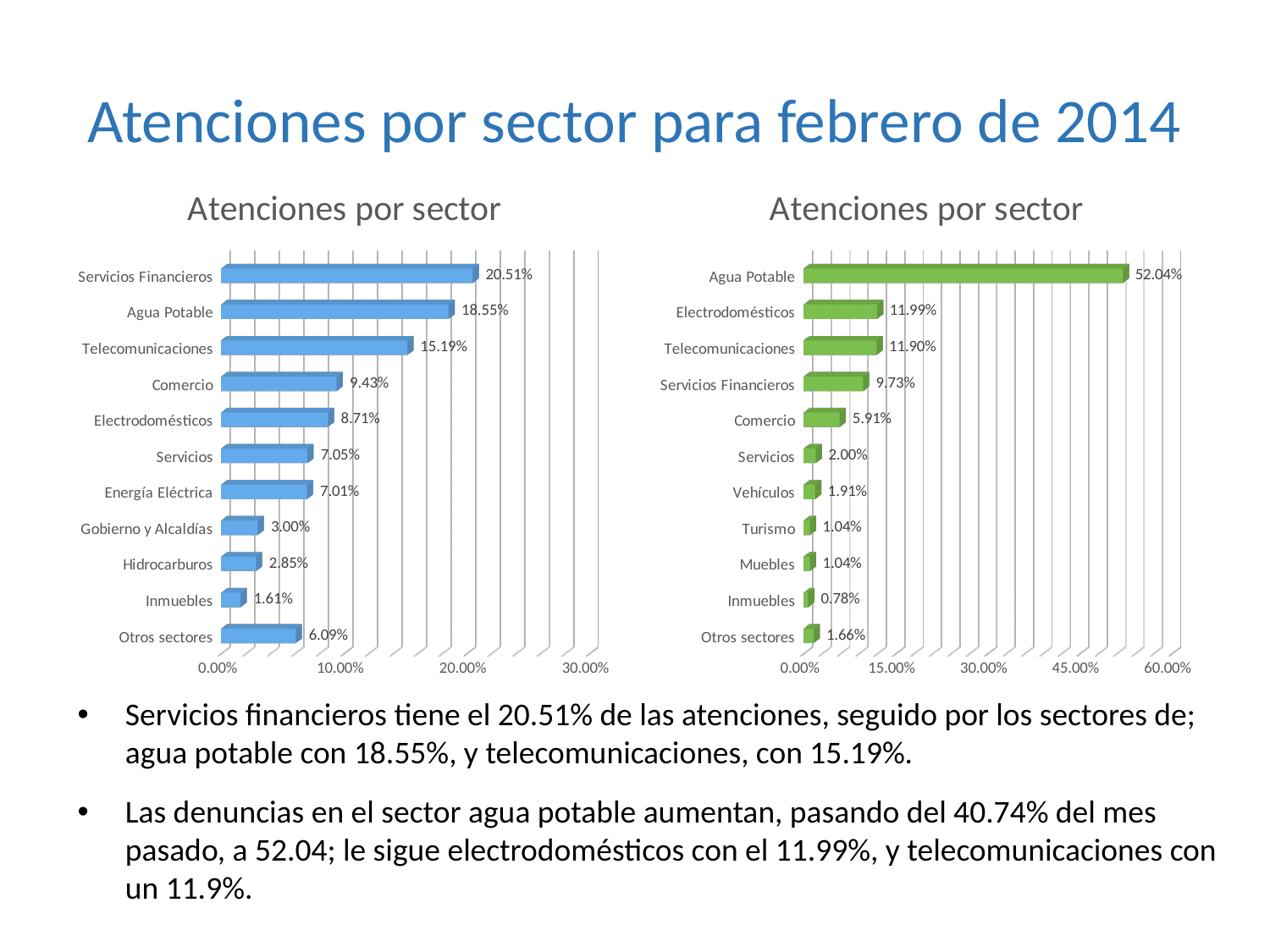
In the right chart, which is larger, Comercio or Servicios? Comercio In the left chart, is the value for Comercio greater or less than 10.00%? less In the left chart, which category has the lowest value? Inmuebles In the left chart, what is the value for Hidrocarburos? 2.85% How many categories are shown in the right chart? 11 In the left chart, what is the value for Servicios Financieros? 20.51% In the right chart, what is the value for Vehículos? 1.91% In the right chart, which category has the highest value? Agua Potable In the right chart, what is the value for Agua Potable? 52.04% In the left chart, what is the difference between Agua Potable and Telecomunicaciones? 3.36% What is the title of the right chart? Atenciones por sector What kind of chart is the left chart? Bar chart